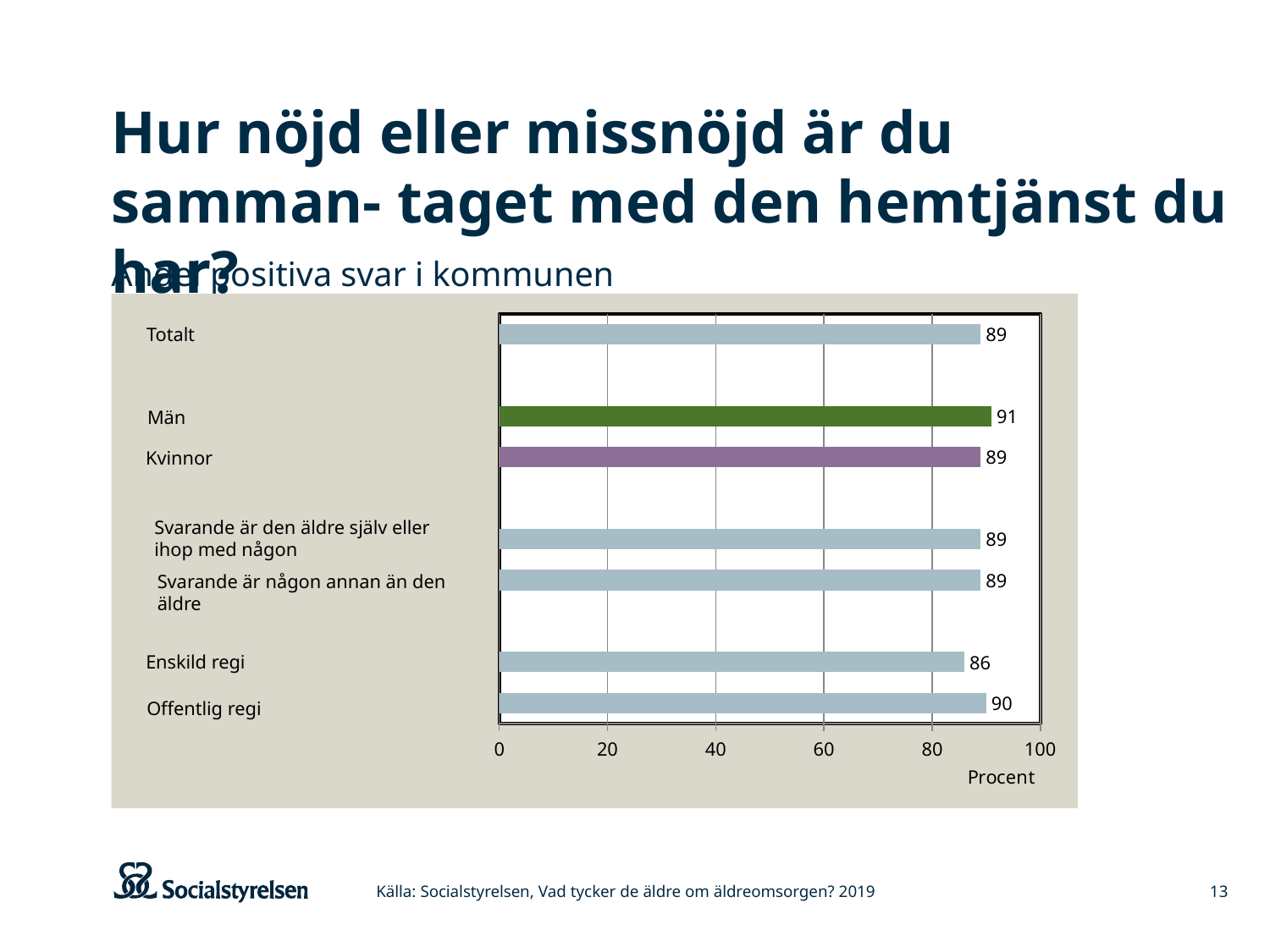
What is the value for Offentlig regi? 90 What is the label on the horizontal axis of the chart? Procent What kind of chart is shown on the slide? Bar chart What is the value for Män? 91 What is the difference between the values for Män and Kvinnor? 2 Which category has the lowest value? Enskild regi Which category has the highest value? Män What is the value for Totalt? 89 What is the difference between the values for Offentlig regi and Enskild regi? 4 How many categories are shown in the chart? 7 Which is larger, the value for Offentlig regi or the value for Enskild regi? Offentlig regi What is the value for Enskild regi? 86